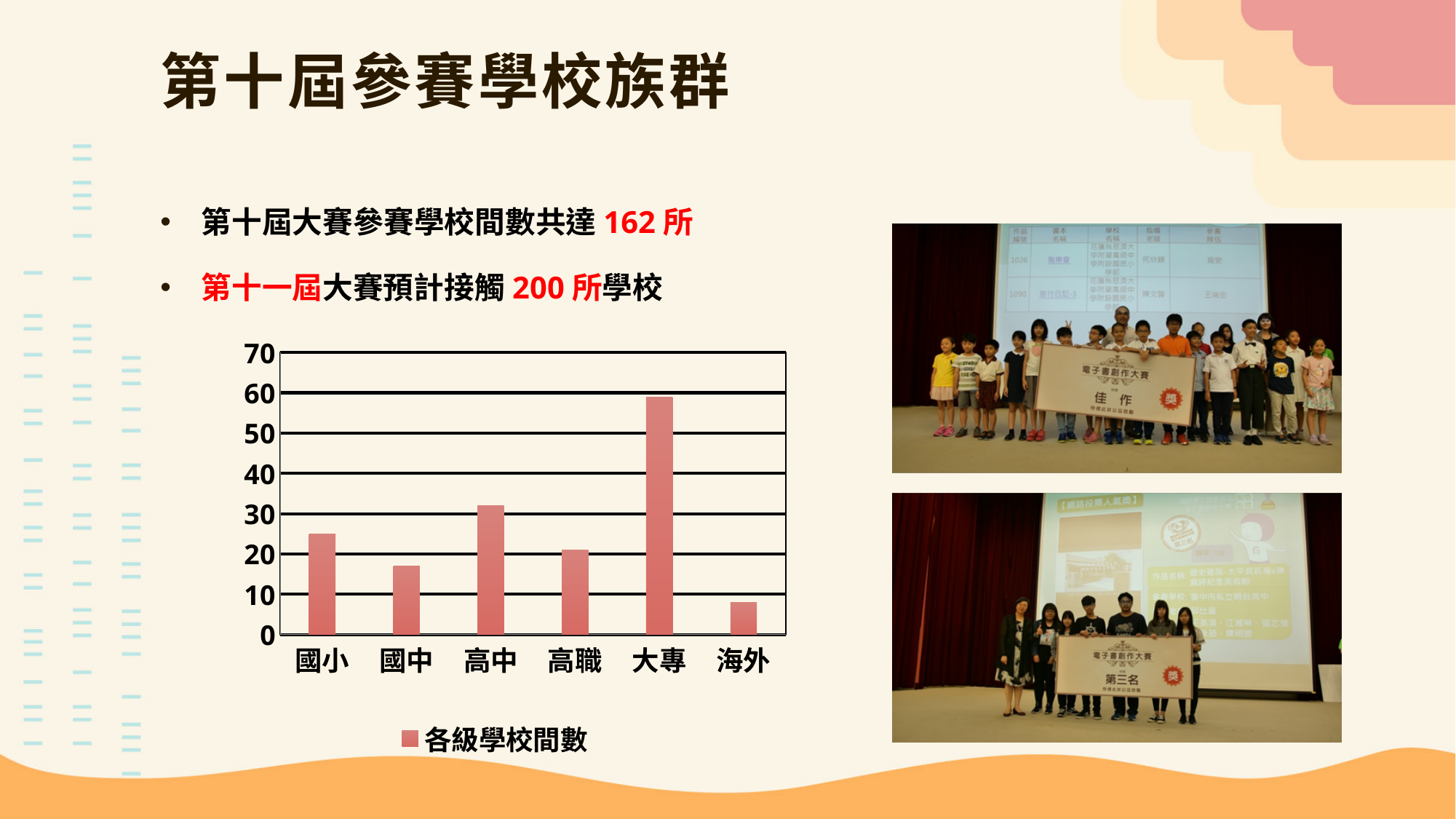
What kind of chart is shown on the slide? bar chart How many categories are shown on the x axis of the chart? 6 Is the value for 海外 greater or less than 10? less How many series does the chart legend list? 1 Is the value for 國小 greater or less than 20? greater Which category has the lowest value in the bar chart? 海外 Is the value for 大專 greater or less than 50? greater Which has a larger value, 高中 or 高職? 高中 Which category has the highest value in the bar chart? 大專 Which has a larger value, 國小 or 國中? 國小